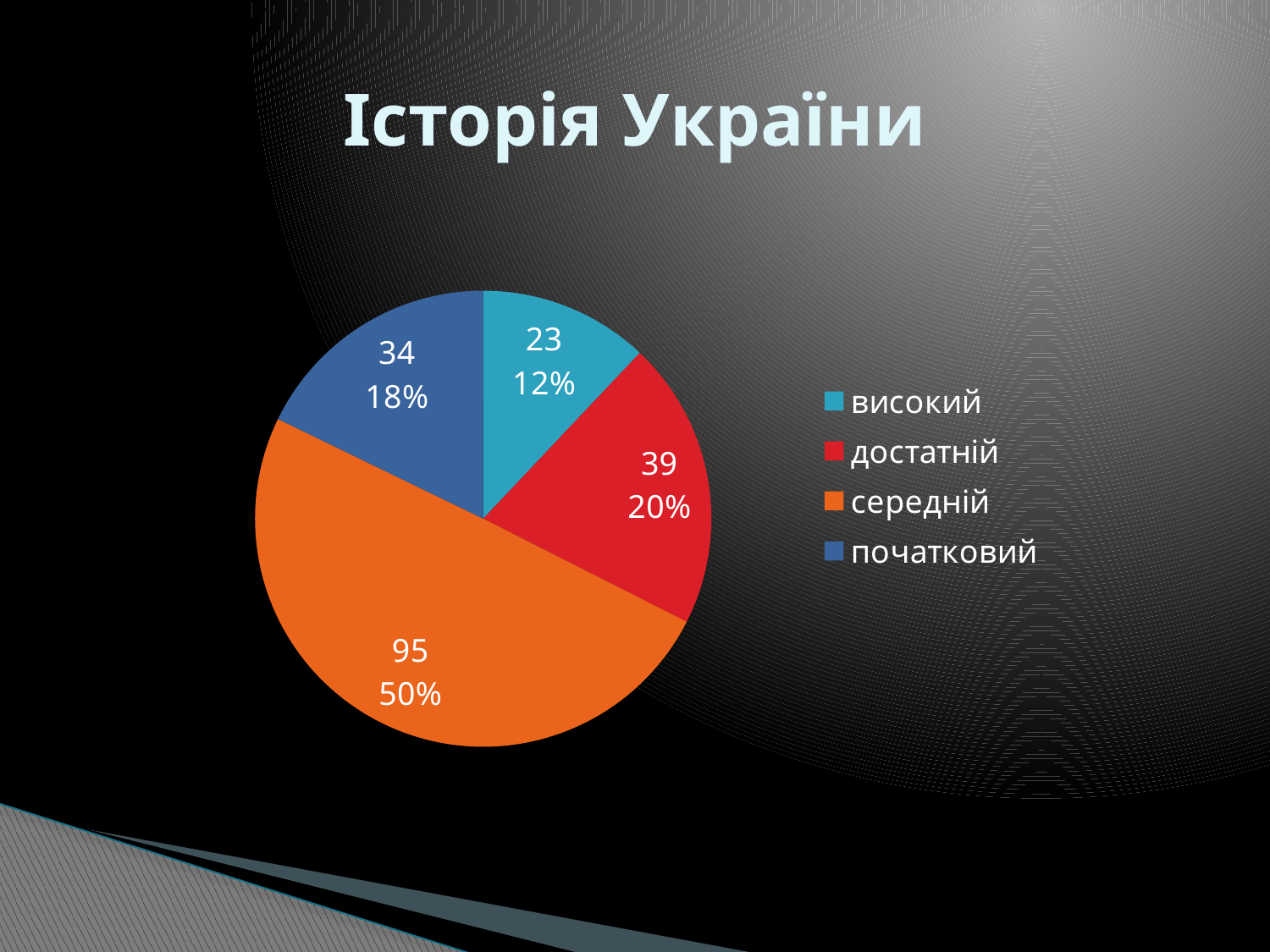
What type of chart is shown on the slide? pie chart What percentage share does the "високий" slice have? 12% What is the total of all the slice values? 191 What percentage share does the "початковий" slice have? 18% How many slices does the pie chart have? 4 Which is larger, the value for "достатній" or the value for "початковий"? достатній Which category has the largest slice? середній What is the difference between the values for "середній" and "достатній"? 56 What is the value for the "достатній" slice? 39 What is the title of the slide? Історія України Which category has the smallest slice? високий What is the value for the "середній" slice? 95